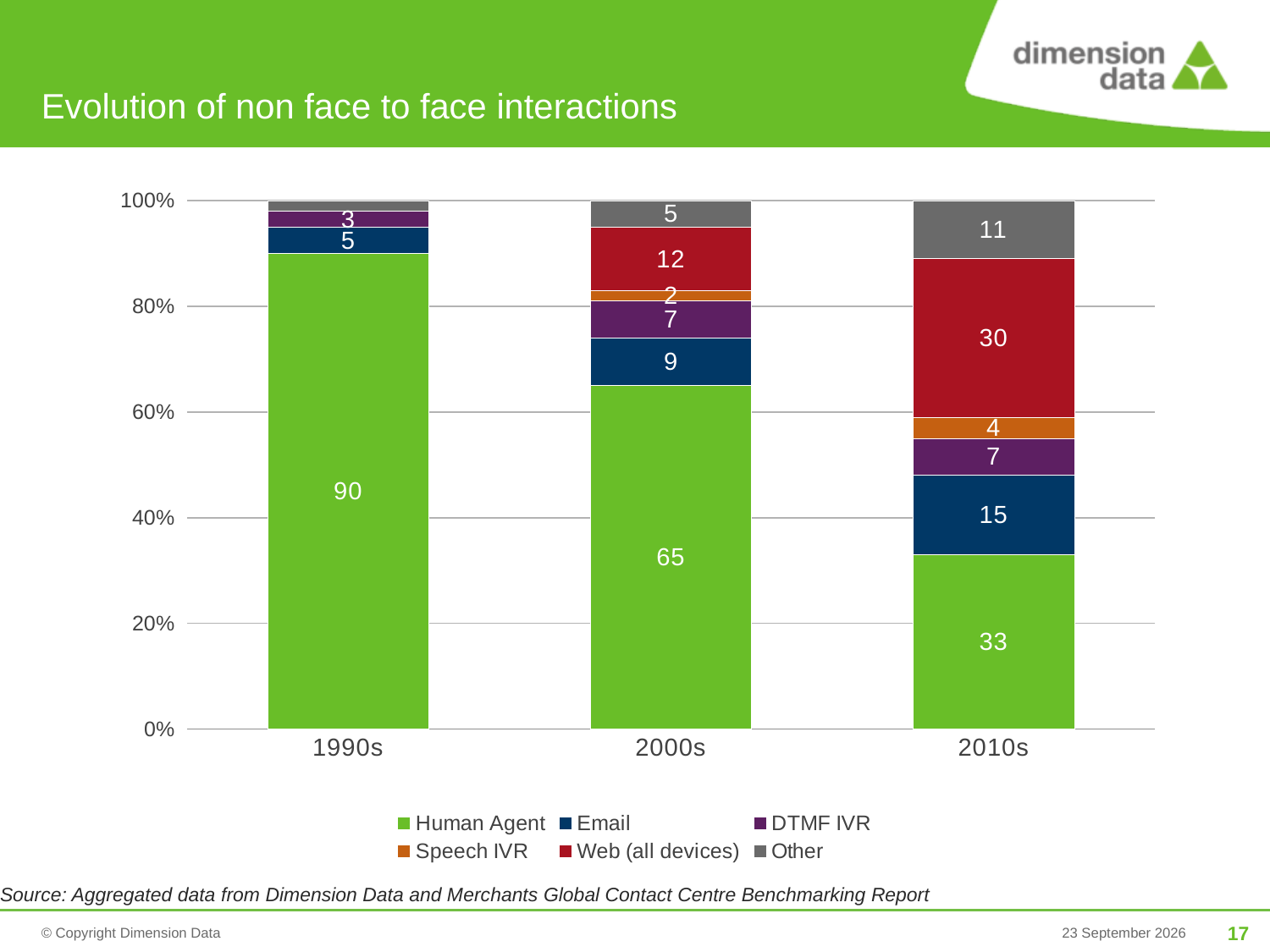
Which decade has the highest Human Agent value? 1990s What is the Email value for the 1990s? 5 What is the Human Agent value for the 2000s? 65 How does the Human Agent value change from the 1990s to the 2010s? It falls Which is larger in the 2010s, the Email value or the Other value? Email Which decade has the lowest Human Agent value? 2010s How many series does the legend list? 6 What type of chart is shown on the slide? Stacked bar chart How many decades are shown on the x axis? 3 What is the difference between the Human Agent values for the 1990s and the 2010s? 57 What is the Speech IVR value for the 2000s? 2 What is the Web (all devices) value for the 2010s? 30